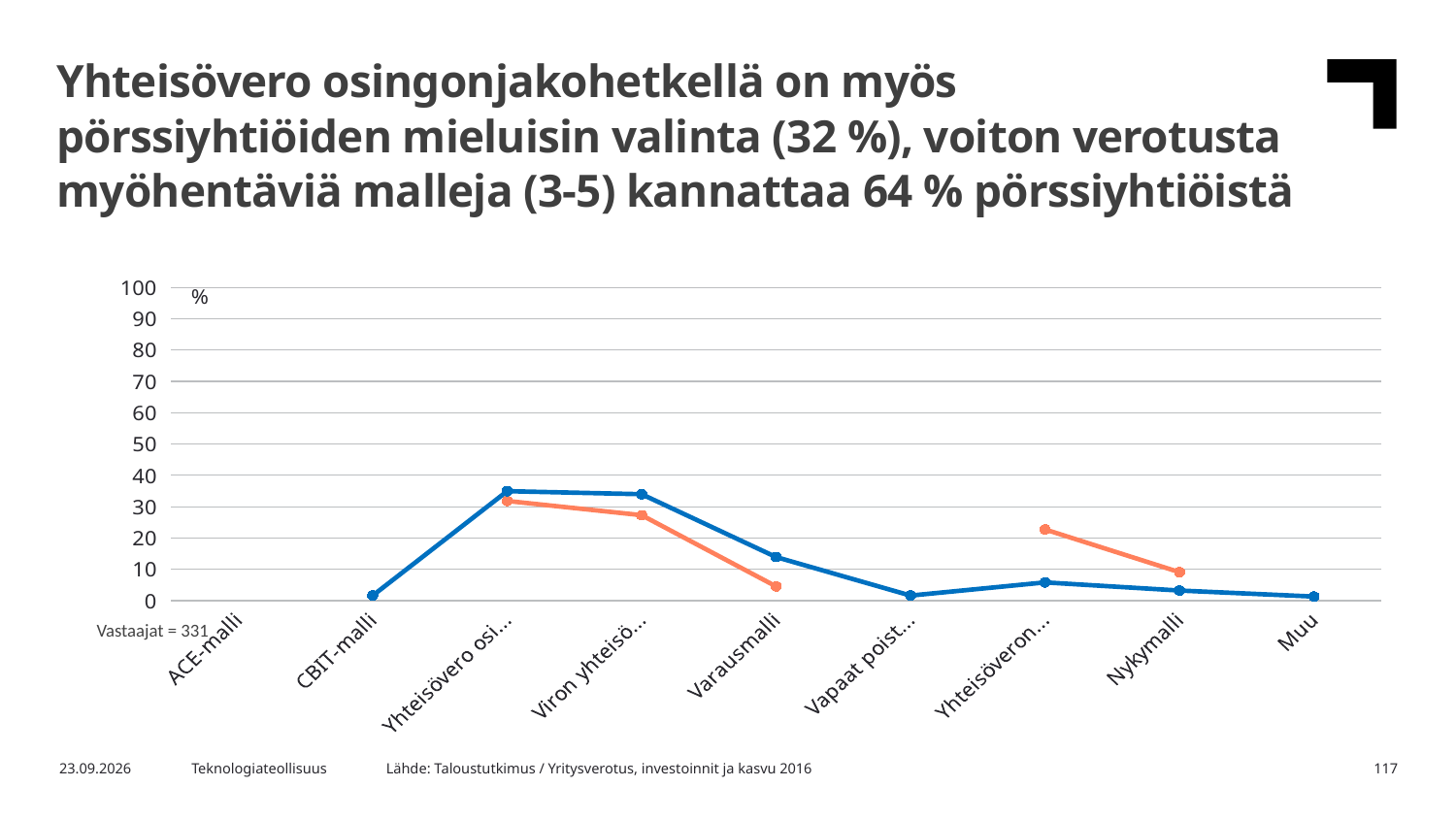
How many categories are shown on the x axis of the chart? 9 Is the value of the blue line for 'Varausmalli' greater or less than 20? less What kind of chart is shown on the slide? line chart For which category does the orange line reach its highest value? Yhteisövero osi... Is the value of the orange line for 'Yhteisöveron...' greater or less than 30? less What unit is shown at the top of the vertical axis? % Is the value of the blue line for 'Yhteisövero osi...' greater or less than 30? greater At 'Varausmalli', which line has the higher value, the blue or the orange? blue At 'Yhteisöveron...', which line has the higher value, the blue or the orange? orange Does the blue line rise or fall from 'Viron yhteisö...' to 'Vapaat poist...'? fall